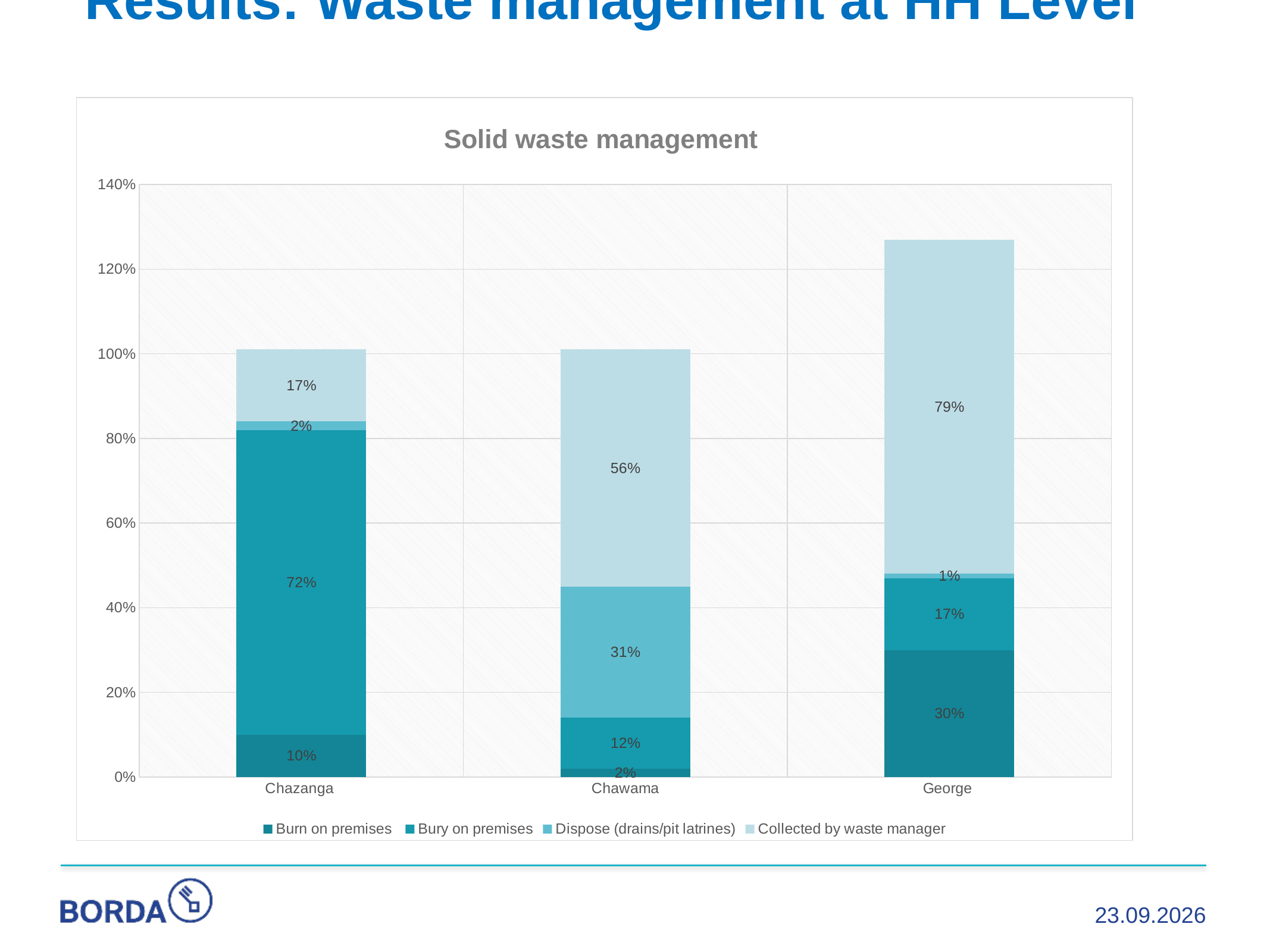
What is the value for Bury on premises in Chazanga? 72% How many categories are shown on the x axis? 3 What kind of chart is shown on the slide? Stacked bar chart What is the value for Dispose (drains/pit latrines) in Chawama? 31% Which category has the highest value for Collected by waste manager? George What is the total of the stacked bar for George? 127% What is the difference between the Collected by waste manager values for George and Chawama? 23% What is the value for Collected by waste manager in George? 79% What is the value for Burn on premises in George? 30% Which category has the lowest value for Burn on premises? Chawama How many series does the legend list? 4 Which is larger: Bury on premises in Chazanga or Bury on premises in George? Chazanga